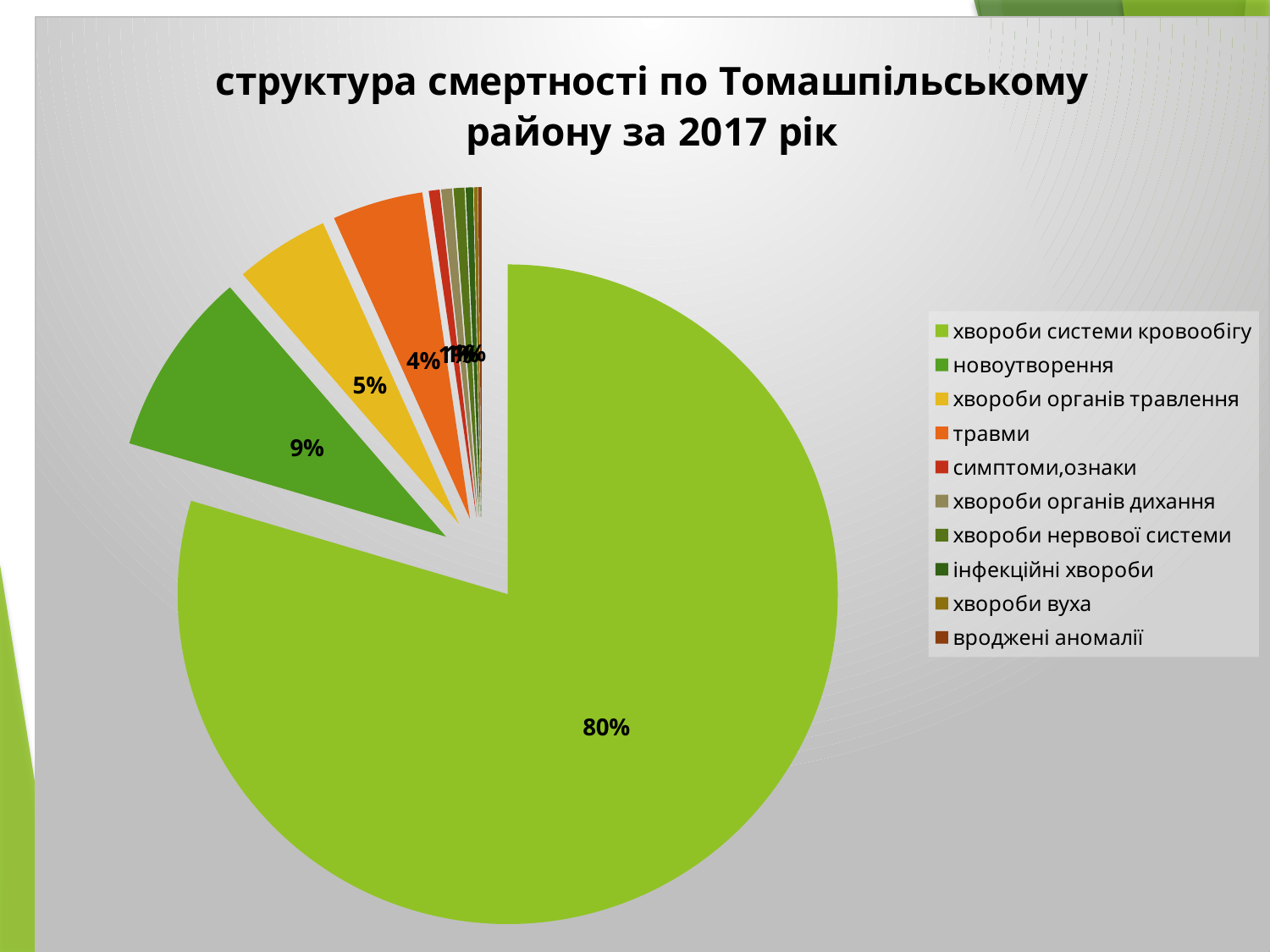
What is the value shown for "травми"? 4% What is the title of the chart? структура смертності по Томашпільському району за 2017 рік What kind of chart is shown on the slide? pie chart How many categories does the legend of the pie chart list? 10 What is the value shown for "хвороби органів травлення"? 5% What share of the pie does "хвороби системи кровообігу" account for? 80% What is the difference in percentage points between "хвороби системи кровообігу" and "новоутворення"? 71 What is the value shown for "новоутворення"? 9% What is the difference in percentage points between "хвороби органів травлення" and "травми"? 1 Which category is listed first in the legend? хвороби системи кровообігу Which is larger, the slice for "новоутворення" or the slice for "травми"? новоутворення Which category has the largest slice of the pie? хвороби системи кровообігу